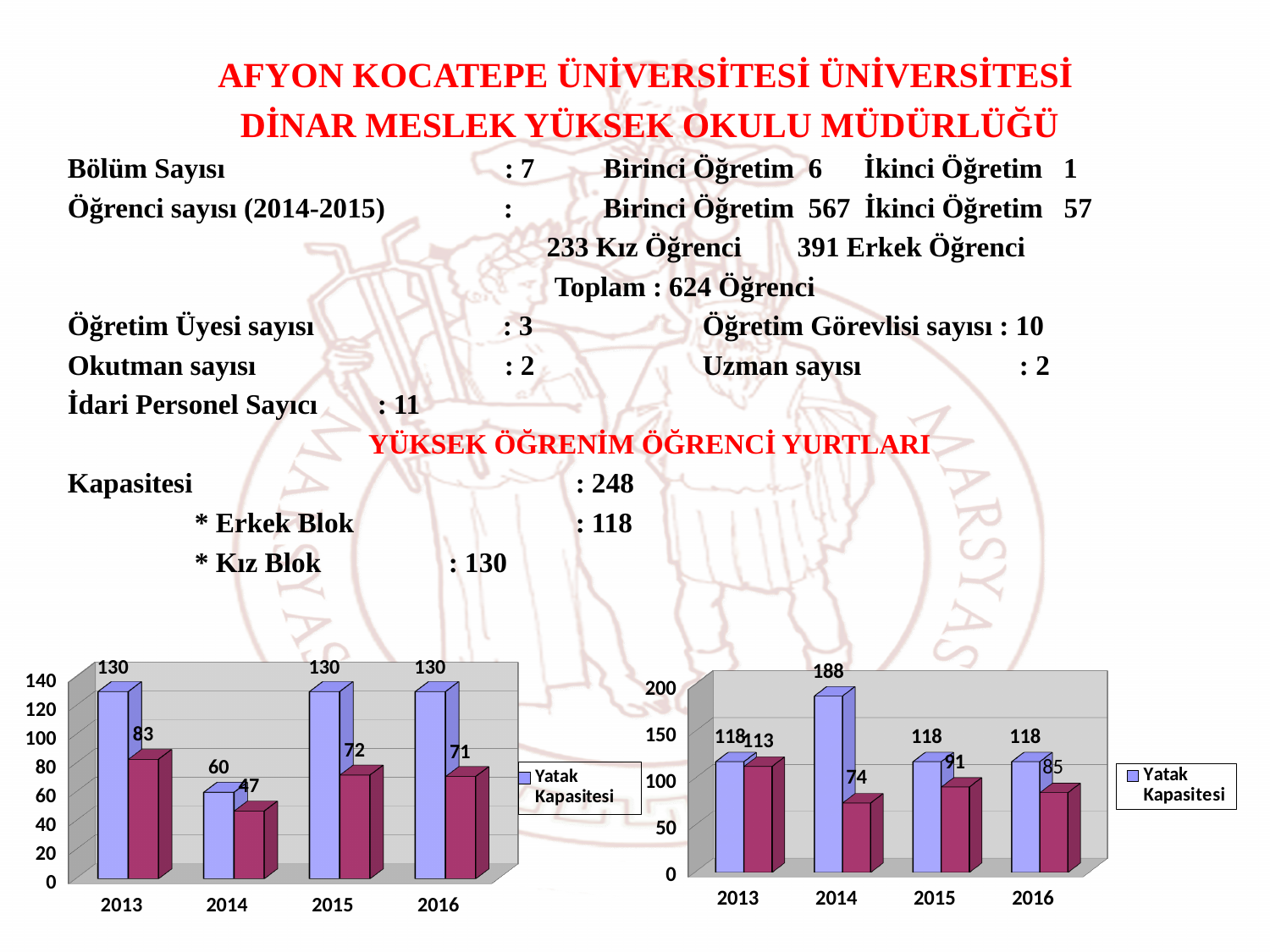
In the right chart, what is the difference between the Yatak Kapasitesi value and the red bar value for 2014? 114 What series name is listed in the legend of the left chart? Yatak Kapasitesi In the left chart, what value is shown on the red bar for 2013? 83 What type of chart is the right chart? bar chart In the left chart, what is the difference between the Yatak Kapasitesi value and the red bar value for 2013? 47 How many years are shown on the x axis of the left chart? 4 In the left chart, what is the Yatak Kapasitesi value for 2014? 60 In the right chart, what value is shown on the red bar for 2015? 91 In the right chart, is the red bar value larger for 2013 or for 2015? 2013 In the right chart, what is the Yatak Kapasitesi value for 2014? 188 In the right chart, which year has the highest Yatak Kapasitesi? 2014 In the left chart, which year has the lowest Yatak Kapasitesi? 2014